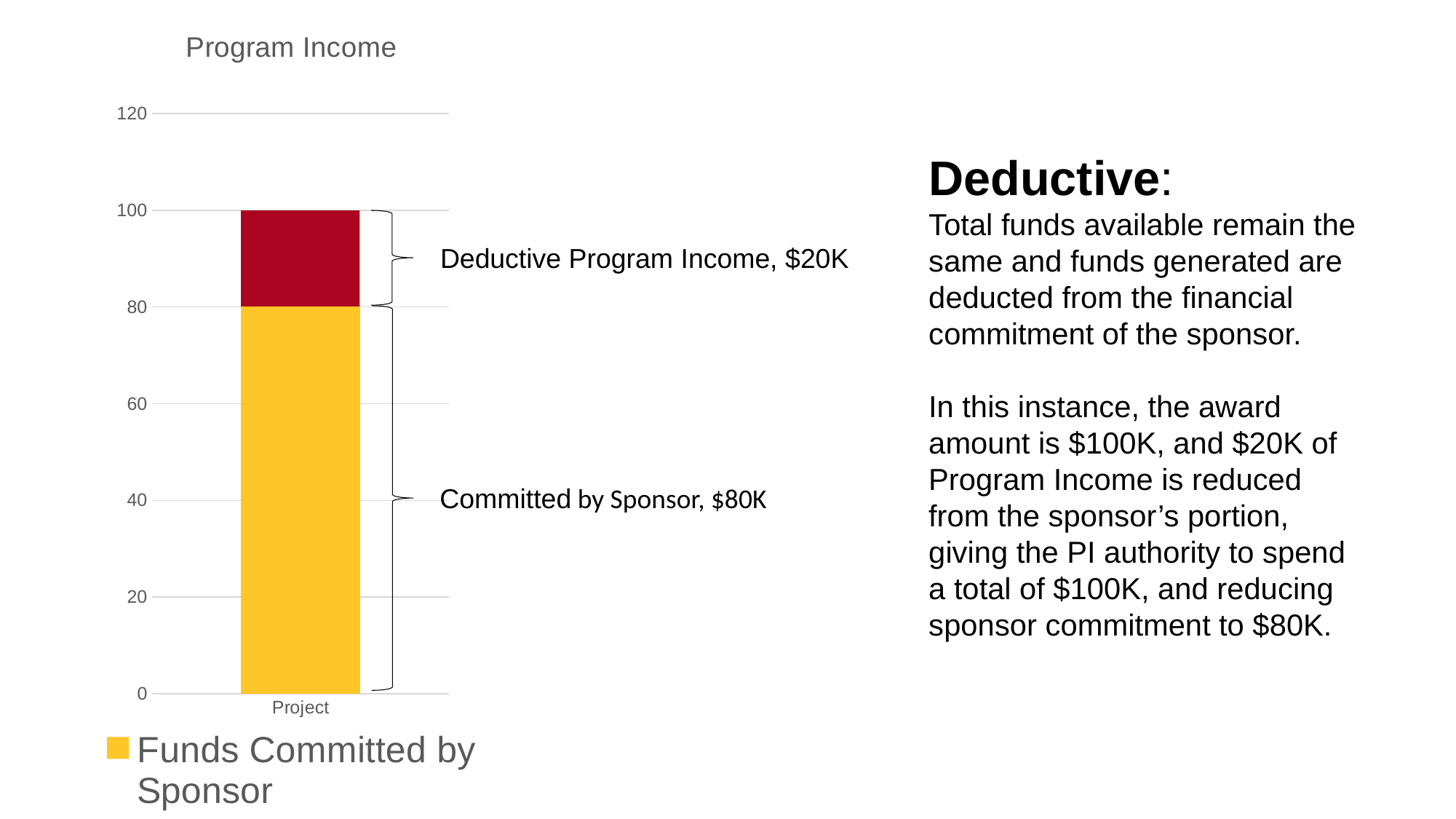
What is the total of the stacked bar for Project? $100K What is the label of the category on the x axis? Project Is the total height of the Project bar greater or less than 120? less What is the difference between the Committed by Sponsor value and the Deductive Program Income value? $60K What value is labelled for Committed by Sponsor in the chart? $80K What is the title of the chart? Program Income Which segment is larger, Committed by Sponsor or Deductive Program Income? Committed by Sponsor How many categories are shown on the x axis of the chart? 1 How many entries does the chart legend list? 1 What kind of chart is shown on the slide? Stacked bar chart What colour is the Committed by Sponsor segment of the bar? Yellow What value is labelled for Deductive Program Income in the chart? $20K